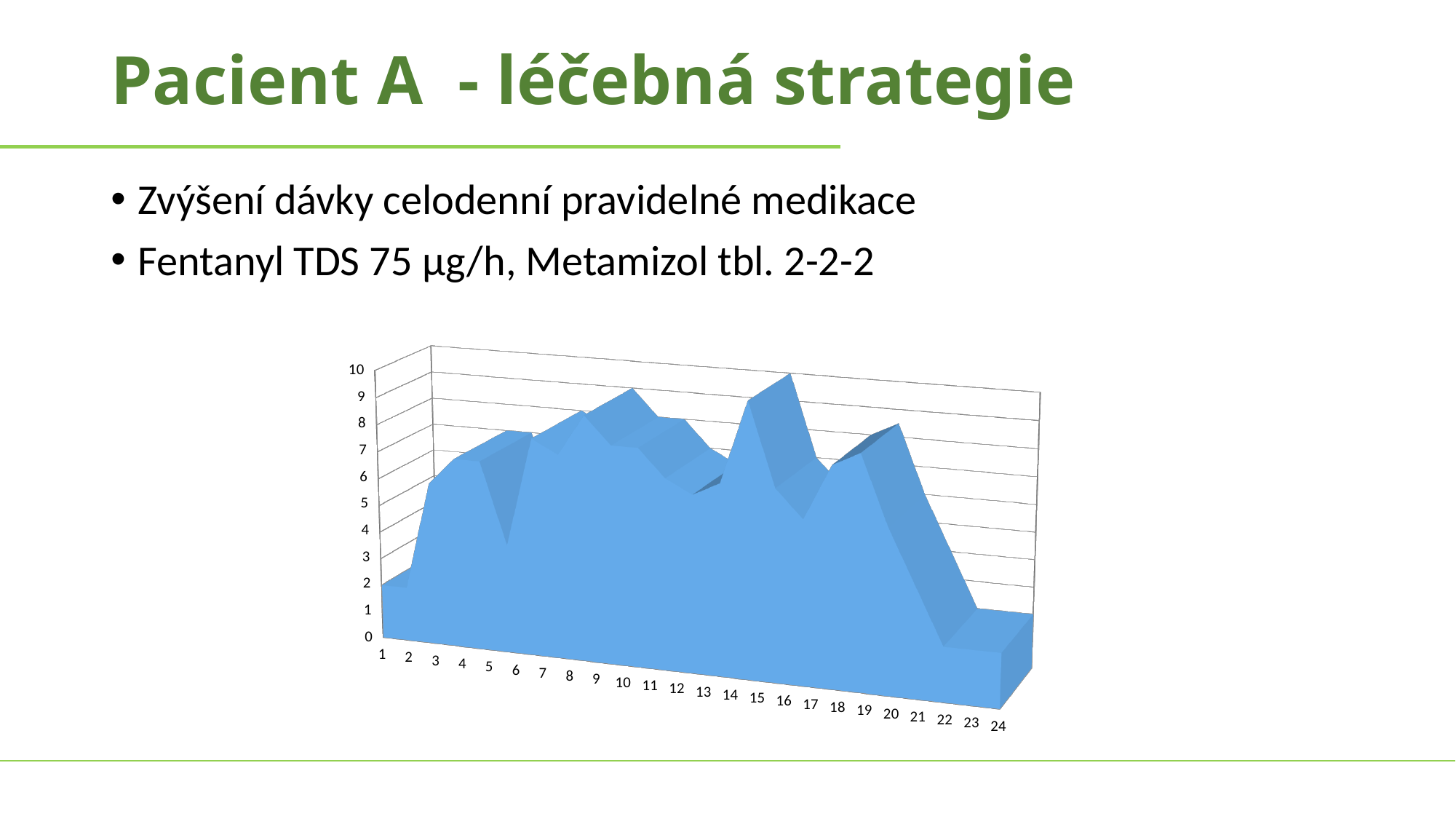
Is the value at point 11 greater or less than 5? greater Is the value at point 1 greater or less than 5? less At which x-axis point does the chart reach its highest value? 15 What is the highest value shown on the vertical axis of the chart? 10 Which has the larger value, point 17 or point 1? point 17 Which has the larger value, point 5 or point 6? point 5 Is the value at point 24 greater or less than 5? less What colour is the plotted area in the chart? blue What kind of chart is shown on the slide? area chart Do the values rise or fall from point 21 to point 24? fall How many points are plotted along the x axis of the chart? 24